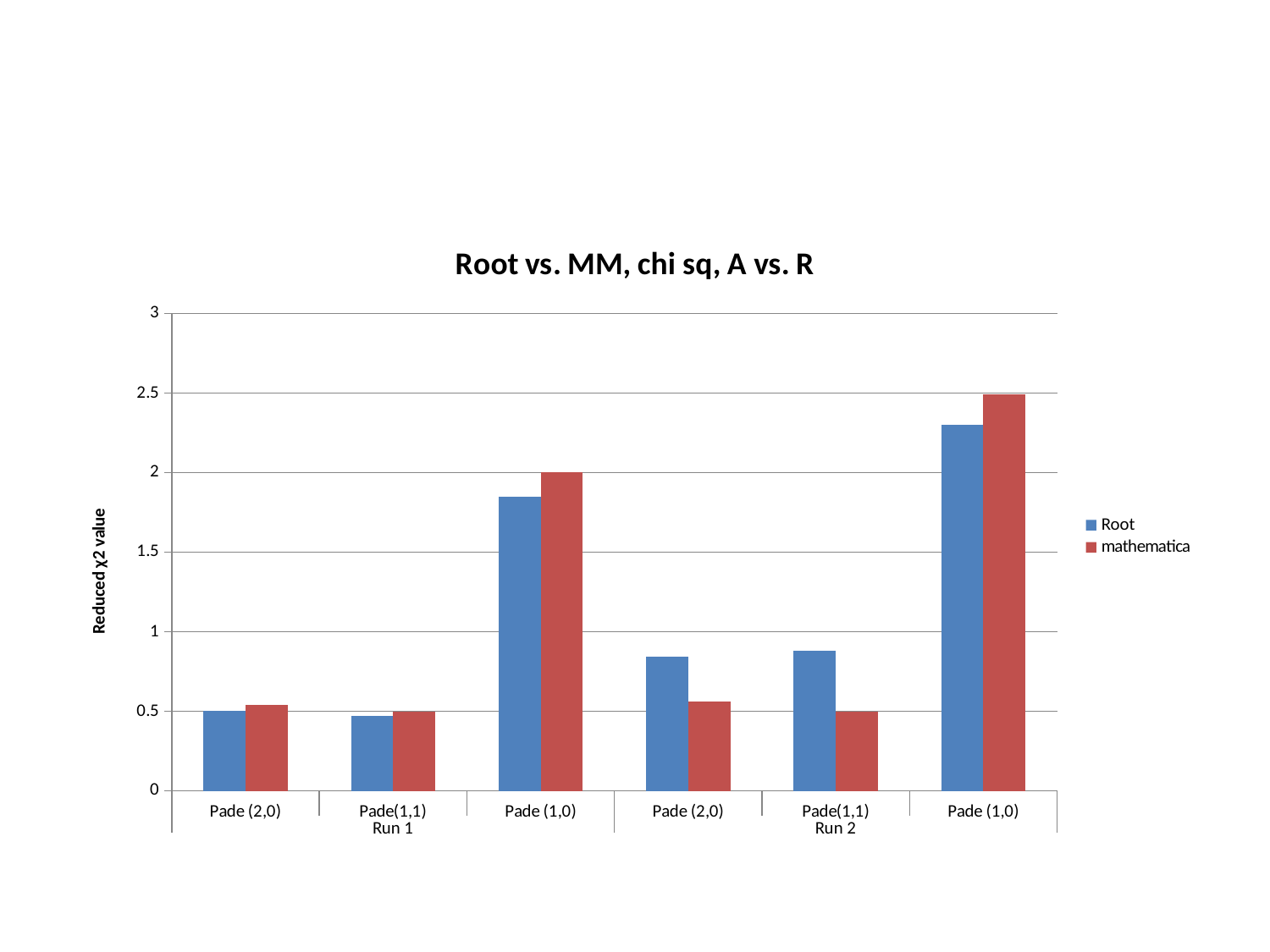
What is the title of the chart? Root vs. MM, chi sq, A vs. R For Pade (2,0) in Run 2, which series has the larger value, Root or mathematica? Root For Pade (1,0) in Run 1, which series has the larger value, Root or mathematica? mathematica How many series does the legend list? 2 Which category has the highest Root value? Pade (1,0) in Run 2 Is the Root value for Pade(1,1) in Run 2 greater or less than 1? less How many categories are plotted along the x axis? 6 What kind of chart is shown on the slide? Bar chart Which category has the highest mathematica value? Pade (1,0) in Run 2 Is the mathematica value for Pade (1,0) in Run 1 greater or less than 1.5? greater What is the label on the vertical axis? Reduced χ2 value Is the Root value for Pade (1,0) in Run 2 greater or less than 2? greater